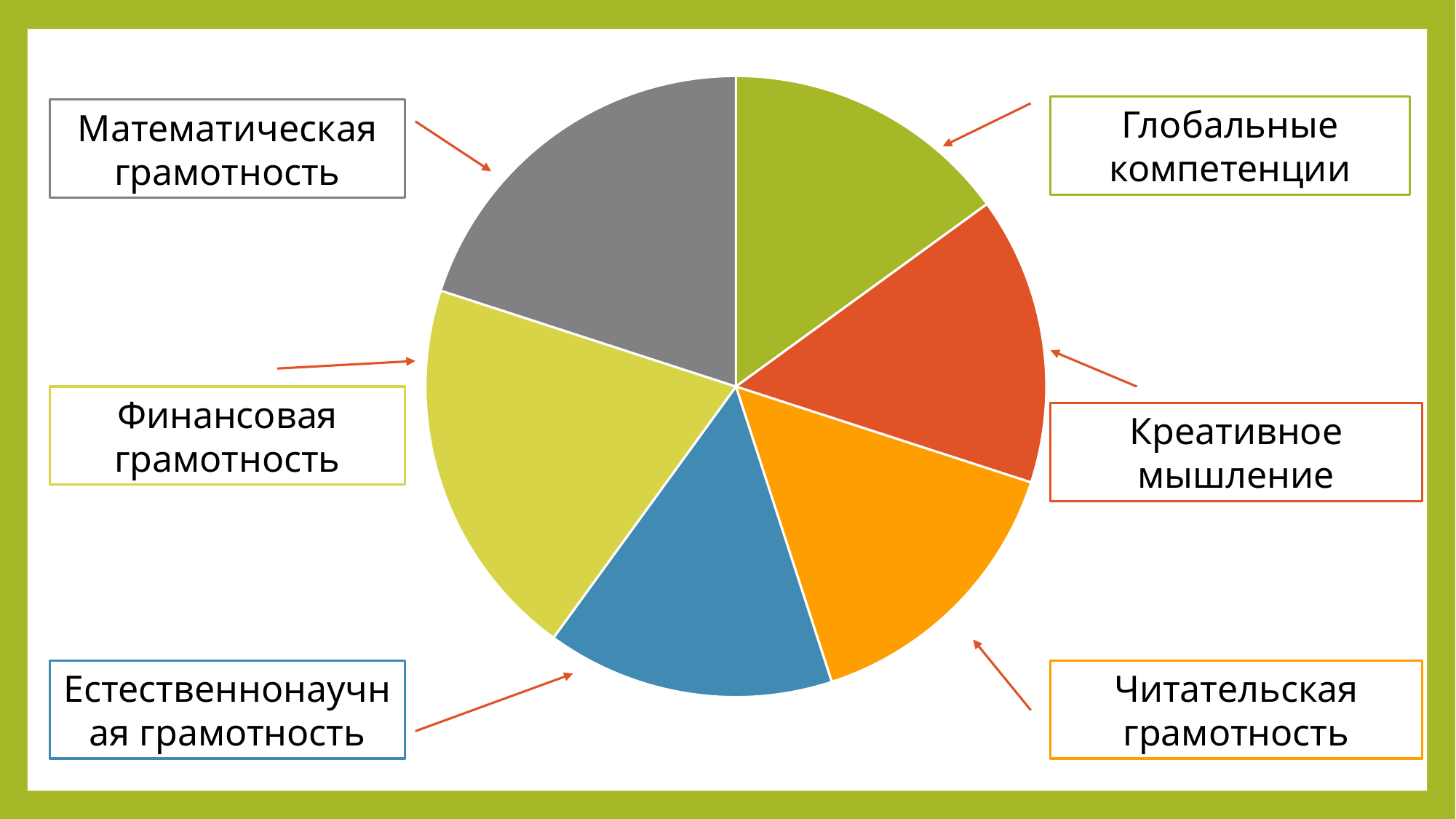
How many slices does the pie chart have? 6 What colour is the slice labelled Естественнонаучная грамотность? blue Which label points to the grey slice of the pie chart? Математическая грамотность What kind of chart is shown on the slide? pie chart Which slice is larger: Финансовая грамотность or Креативное мышление? Финансовая грамотность Which slice is larger: Математическая грамотность or Глобальные компетенции? Математическая грамотность Which slice is larger: Математическая грамотность or Читательская грамотность? Математическая грамотность